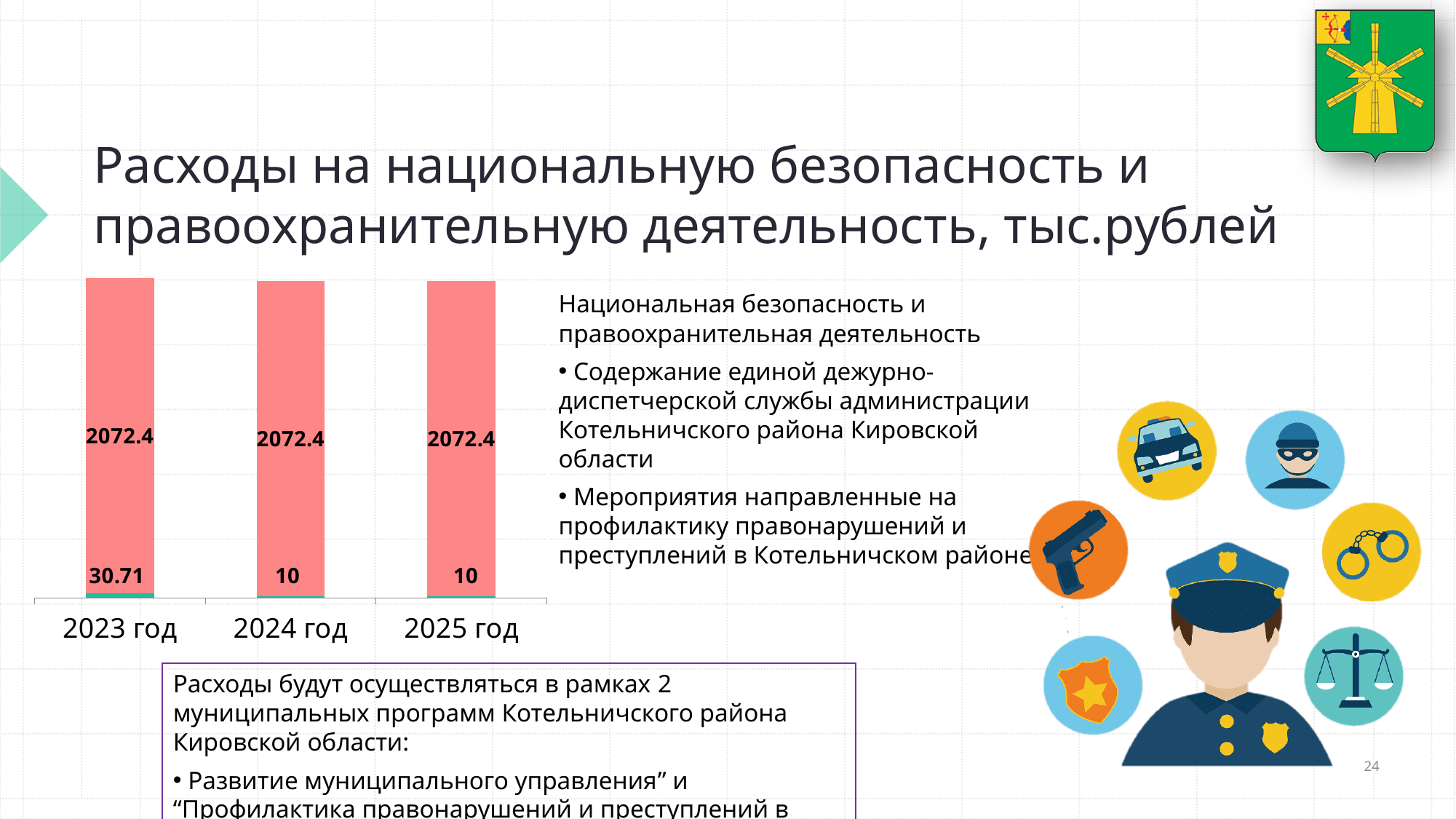
What is the value of the small green segment for 2024 год? 10 Is the green segment value for 2023 год larger or smaller than the green segment value for 2025 год? larger What is the total of the stacked bar for 2024 год? 2082.4 What unit is stated in the chart's title? тыс.рублей What is the value of the small green segment for 2023 год? 30.71 What kind of chart is shown on the slide? bar chart What is the value of the large pink segment for 2025 год? 2072.4 Which year has the highest value for the small green segment? 2023 год What is the total of the stacked bar for 2023 год? 2103.11 What is the difference between the green segment values for 2023 год and 2024 год? 20.71 What is the value of the large pink segment for 2023 год? 2072.4 How many years (categories) are shown on the x axis of the chart? 3